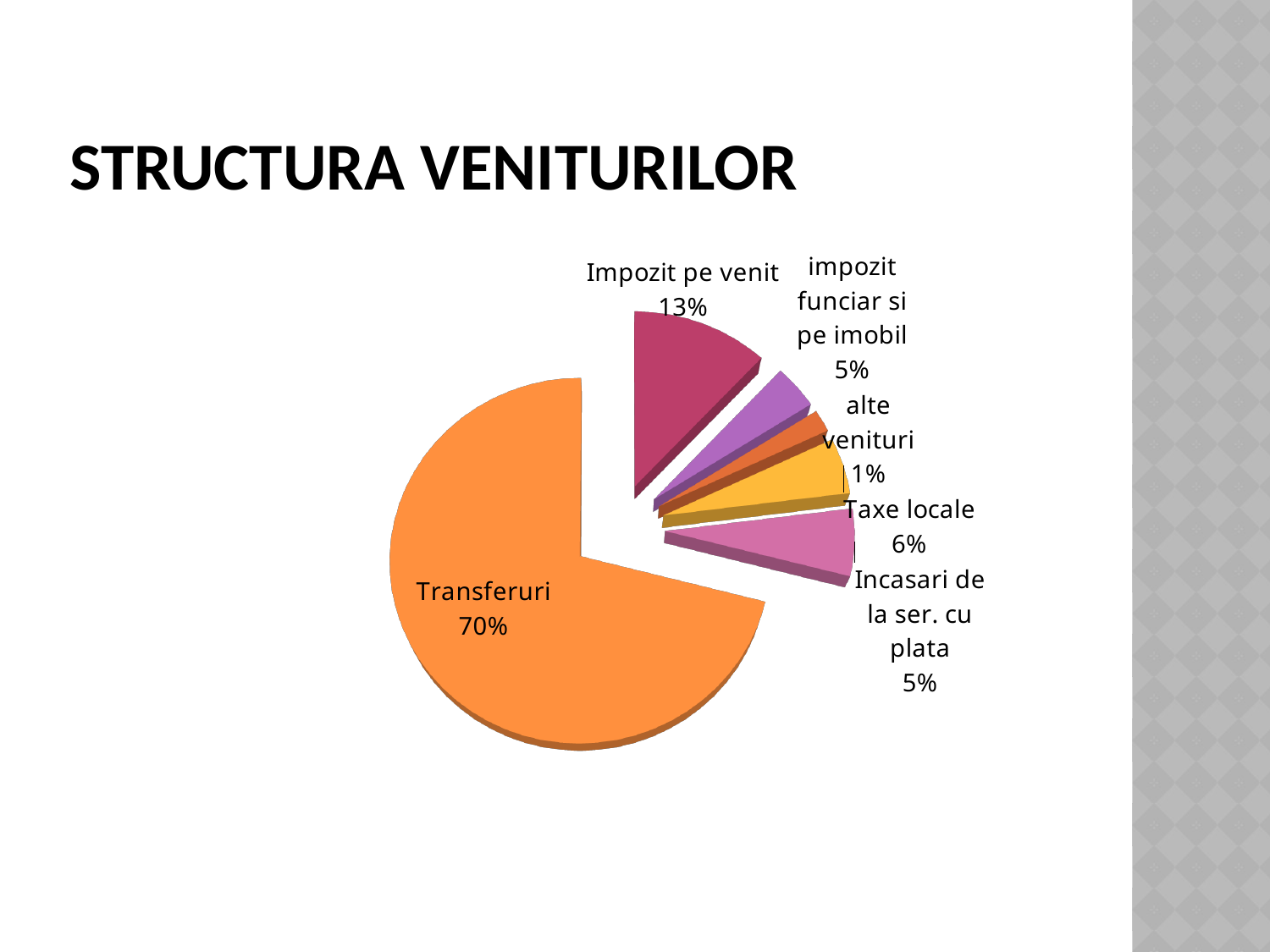
Which category has the largest slice of the pie? Transferuri What share of the pie does alte venituri represent? 1% What is the difference in percentage points between Transferuri and Impozit pe venit? 57 What share of the pie does impozit funciar si pe imobil represent? 5% What kind of chart is shown on the slide? pie chart What share of the pie does Transferuri represent? 70% Which category has the smallest slice of the pie? alte venituri How many slices does the pie chart have? 6 Which is larger, the share for Taxe locale or the share for Incasari de la ser. cu plata? Taxe locale What is the title of the chart on the slide? STRUCTURA VENITURILOR